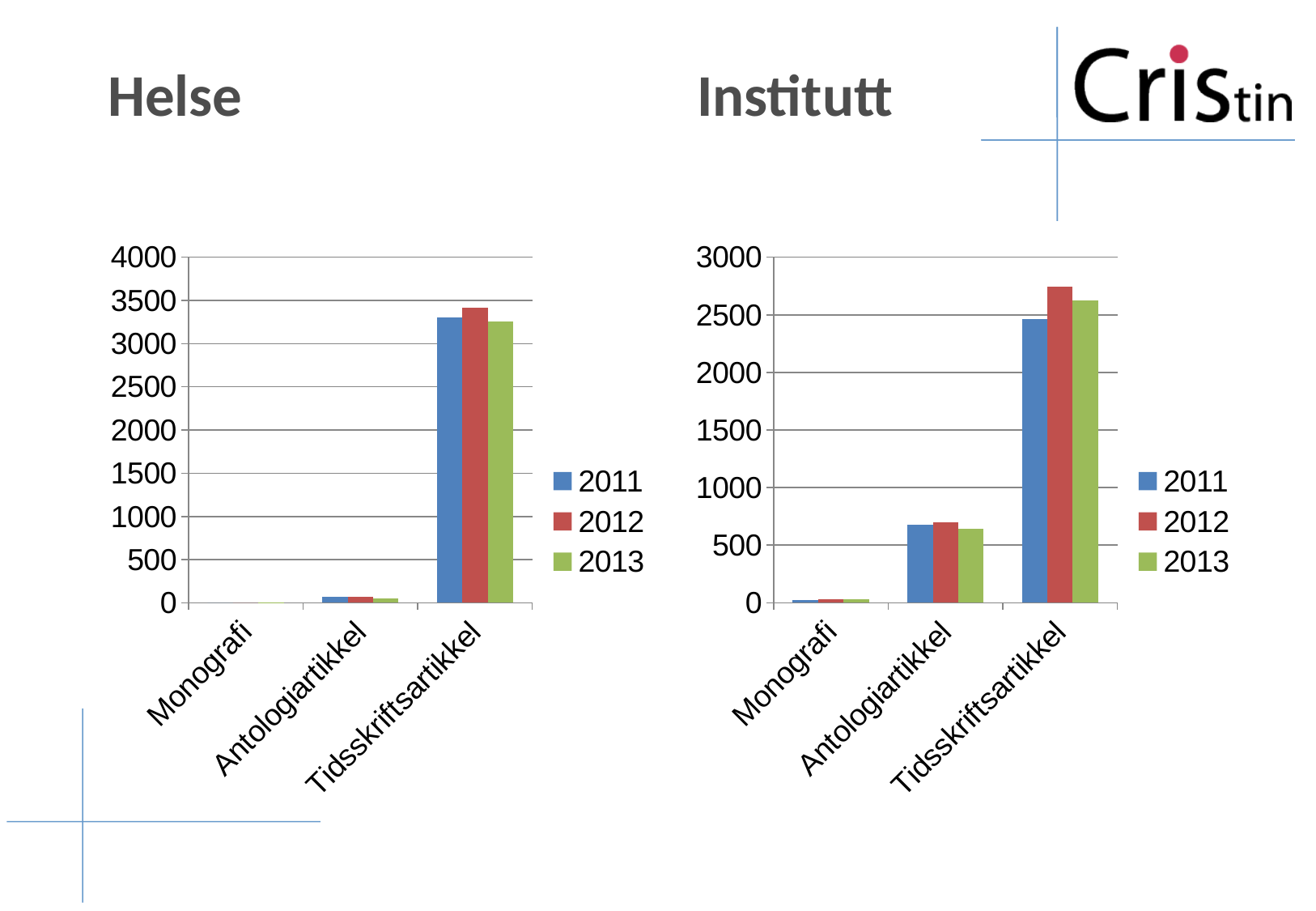
In the Institutt chart, which is larger for Tidsskriftsartikkel: the 2011 value or the 2012 value? 2012 In the Helse chart, is the 2012 value for Tidsskriftsartikkel greater or less than 3000? greater In the Institutt chart, which category has the lowest values? Monografi How many categories are shown on the x axis of the Institutt chart? 3 What is the title of the chart on the right side of the slide? Institutt What kind of chart is the Helse chart on the left? bar chart How many series does the legend of the Helse chart list? 3 In the Helse chart, which is larger for Tidsskriftsartikkel: the 2012 value or the 2013 value? 2012 Which series is shown in red in the legend of the Institutt chart? 2012 In the Helse chart, which category has the highest values? Tidsskriftsartikkel In the Institutt chart, is the 2012 value for Antologiartikkel greater or less than 1000? less